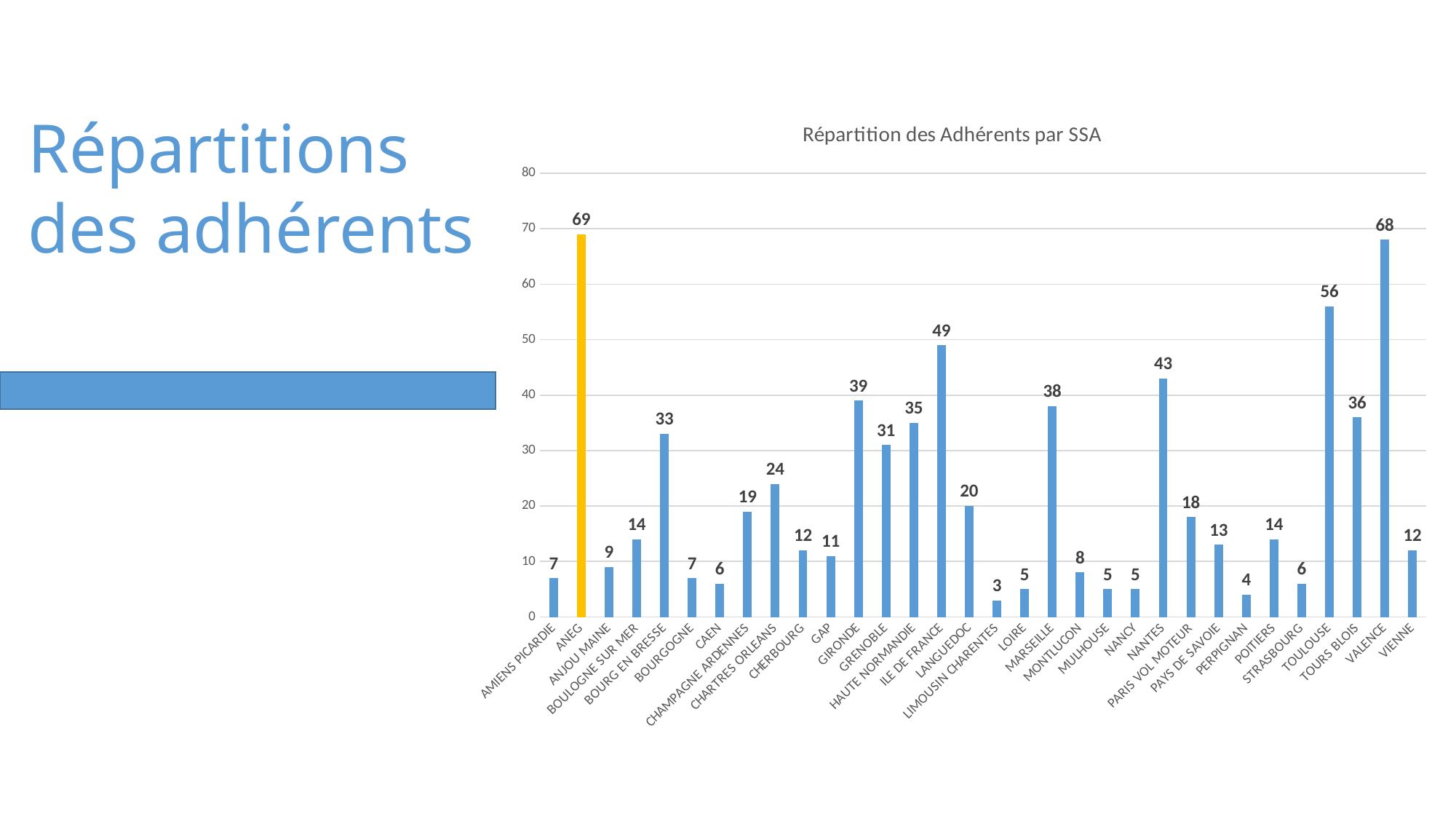
What kind of chart is shown on the slide? bar chart Is the value for TOURS BLOIS greater or less than 30? greater What is the difference between the values for NANTES and MARSEILLE? 5 What is the value for TOULOUSE? 56 Which category has the highest value? ANEG What is the value for LIMOUSIN CHARENTES? 3 What is the difference between the values for ANEG and VALENCE? 1 What is the value for ILE DE FRANCE? 49 What is the title of the chart? Répartition des Adhérents par SSA Which category has the lowest value? LIMOUSIN CHARENTES Which is larger, the value for GIRONDE or the value for HAUTE NORMANDIE? GIRONDE How many categories are shown on the x axis? 32